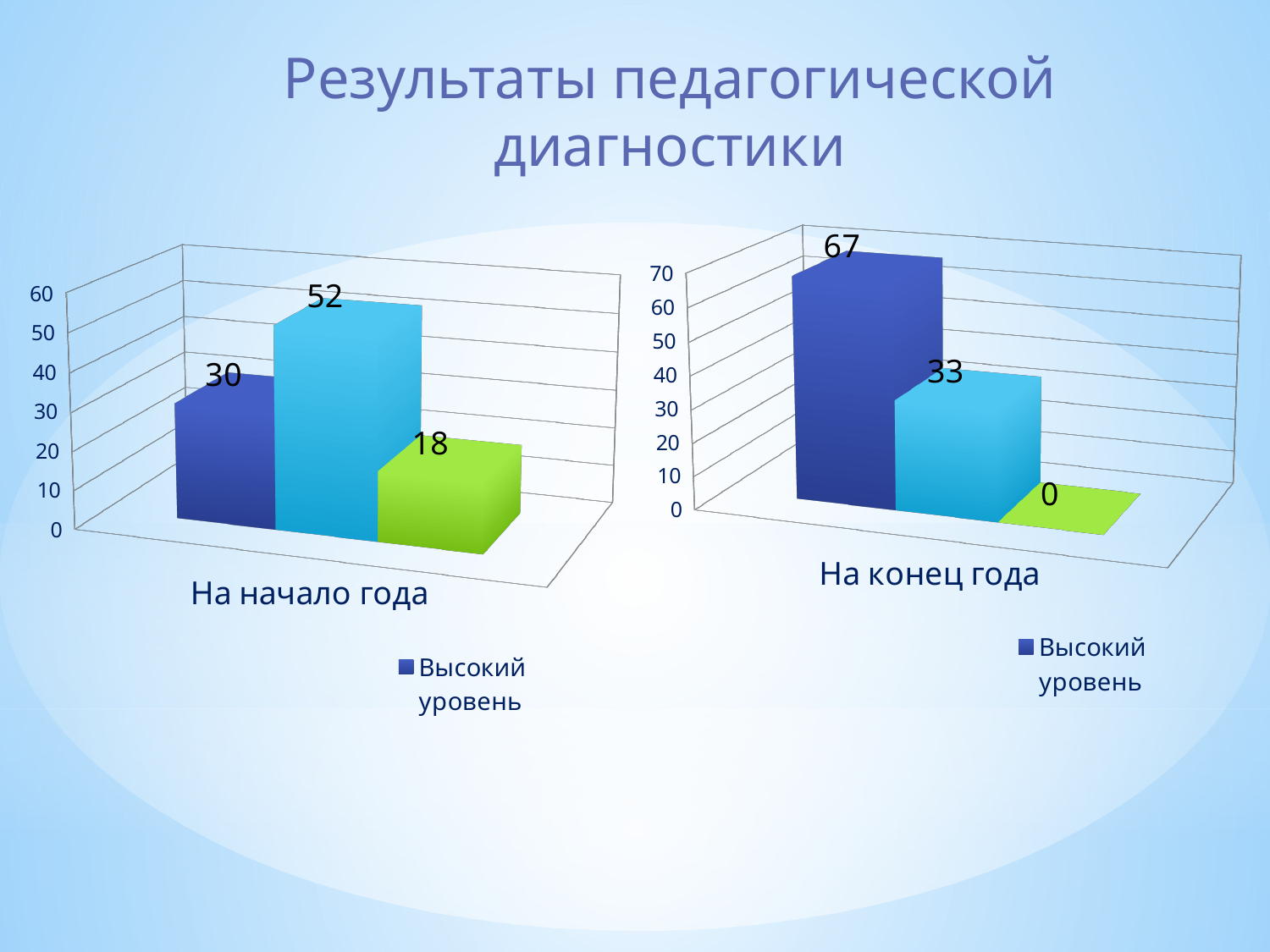
In the left chart (На начало года), what is the value of the green bar? 18 In the left chart (На начало года), what is the value of the light blue bar? 52 In the left chart (На начало года), which bar has the highest value? the light blue bar (52) In the right chart (На конец года), what is the value of the dark blue bar labelled Высокий уровень? 67 How many bars are shown in the right chart (На конец года)? 3 What is the difference between the Высокий уровень value in the right chart (На конец года) and in the left chart (На начало года)? 37 Which is larger: the light blue bar in the left chart (На начало года) or the light blue bar in the right chart (На конец года)? the left chart (52) In the right chart (На конец года), what is the value of the green bar? 0 In the right chart (На конец года), what is the difference between the dark blue bar and the light blue bar? 34 In the left chart (На начало года), what is the value of the dark blue bar labelled Высокий уровень? 30 In the right chart (На конец года), which bar has the lowest value? the green bar (0) What type of chart is used on this slide? bar chart